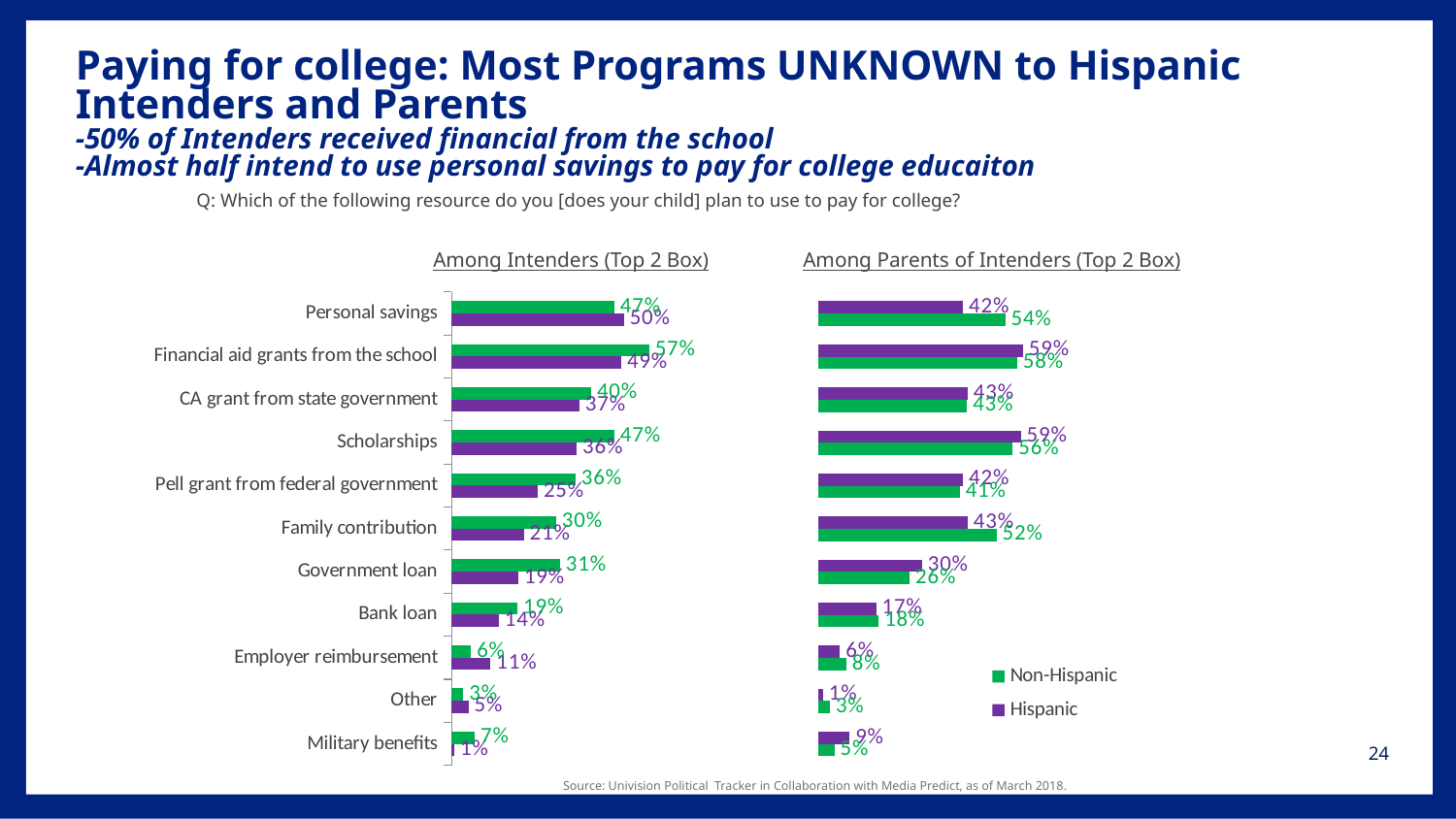
What kind of chart is the Among Parents of Intenders (Top 2 Box) chart? Bar chart How many categories are shown in the Among Intenders (Top 2 Box) chart? 11 In the Among Intenders (Top 2 Box) chart, which category has the lowest Hispanic value? Military benefits In the Among Parents of Intenders (Top 2 Box) chart, what is the Hispanic value for Government loan? 30% How many series does the legend list for the charts on this slide? 2 In the Among Intenders (Top 2 Box) chart, what is the difference between the Non-Hispanic and Hispanic values for Pell grant from federal government? 11 percentage points In the Among Parents of Intenders (Top 2 Box) chart, which is larger for Family contribution: the Hispanic value or the Non-Hispanic value? Non-Hispanic In the Among Intenders (Top 2 Box) chart, which is larger for Employer reimbursement: the Hispanic value or the Non-Hispanic value? Hispanic In the Among Intenders (Top 2 Box) chart, what percentage of Non-Hispanic intenders plan to use financial aid grants from the school? 57% In the Among Parents of Intenders (Top 2 Box) chart, what is the Non-Hispanic value for Personal savings? 54% In the Among Intenders (Top 2 Box) chart, which category has the highest Non-Hispanic value? Financial aid grants from the school In the Among Intenders (Top 2 Box) chart, what is the Hispanic value for Personal savings? 50%